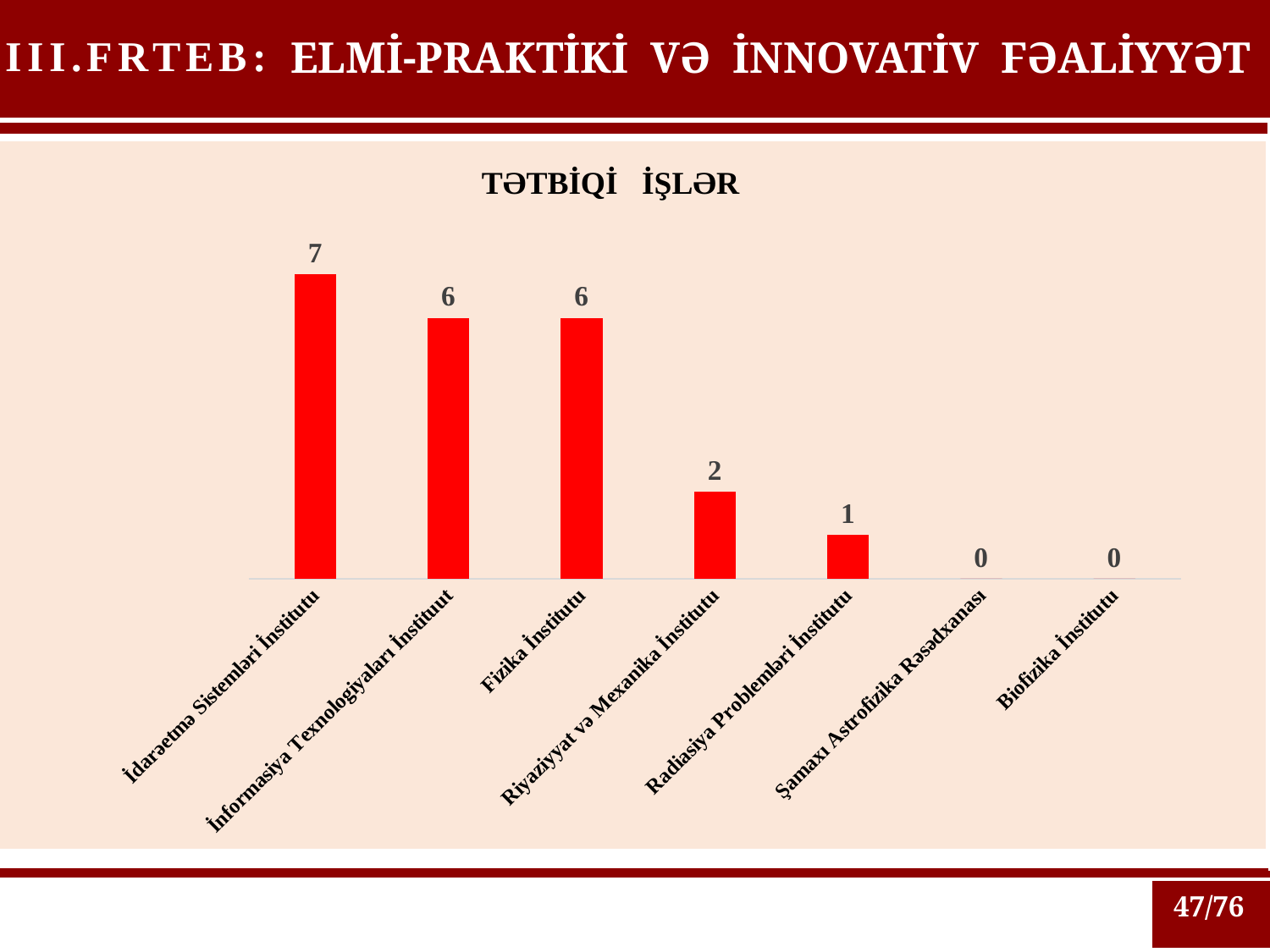
What is the difference between the values for Riyaziyyat və Mexanika İnstitutu and Radiasiya Problemləri İnstitutu? 1 What is the value for Fizika İnstitutu? 6 What is the value for İdarəetmə Sistemləri İnstitutu? 7 Do the values generally rise or fall from left to right along the x axis? fall What is the difference between the values for İdarəetmə Sistemləri İnstitutu and Fizika İnstitutu? 1 What is the value for Riyaziyyat və Mexanika İnstitutu? 2 How many categories are shown on the x axis? 7 What is the title of the chart? TƏTBİQİ İŞLƏR What kind of chart is shown? bar chart Which category has the highest value? İdarəetmə Sistemləri İnstitutu Which is larger, the value for İnformasiya Texnologiyaları İnstitutu or the value for Riyaziyyat və Mexanika İnstitutu? İnformasiya Texnologiyaları İnstitutu What is the value for Radiasiya Problemləri İnstitutu? 1